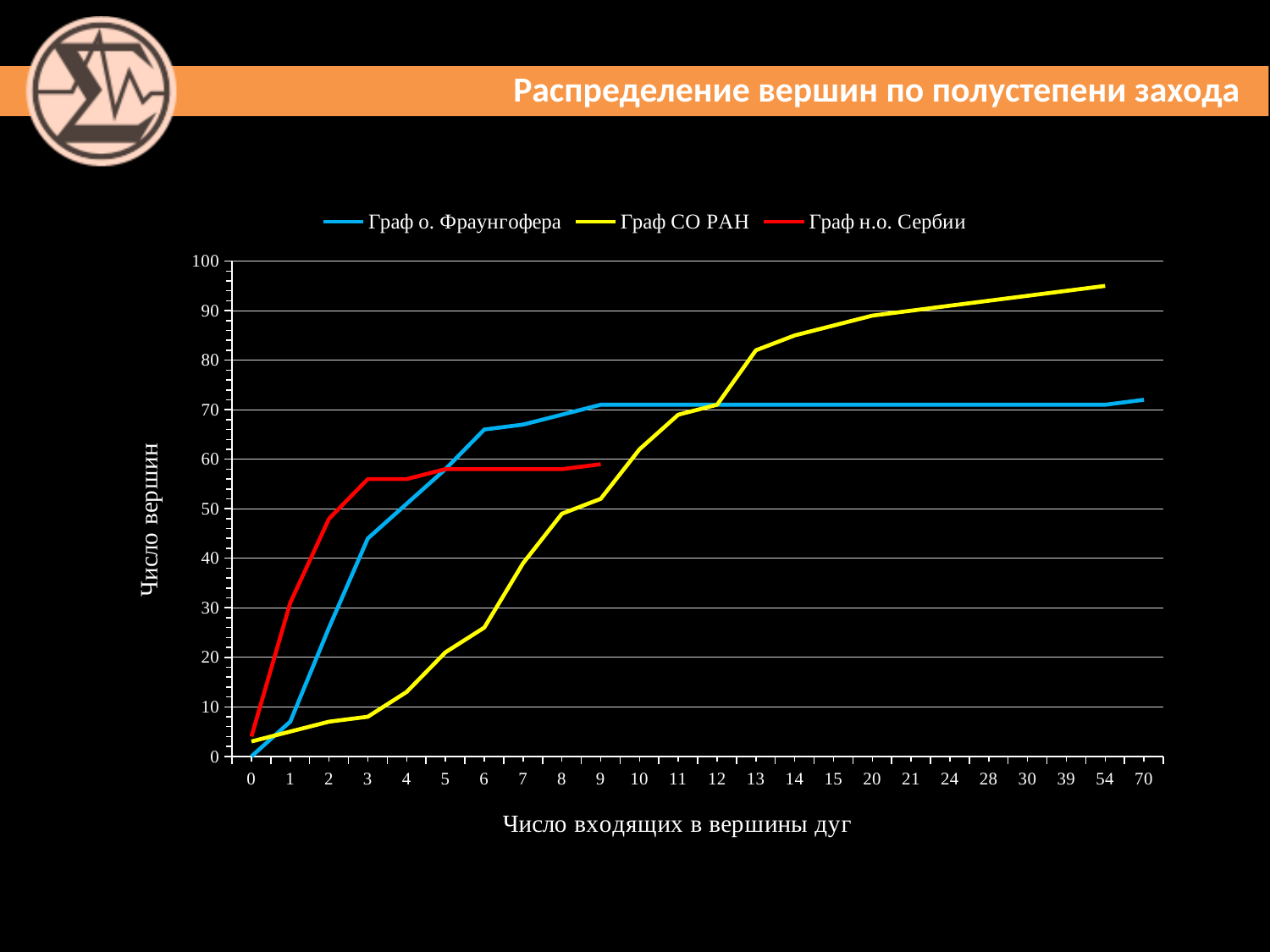
At x = 2, which series has the larger value: Граф н.о. Сербии or Граф о. Фраунгофера? Граф н.о. Сербии What kind of chart is shown on the slide? line chart How many series does the legend list? 3 Is the value for Граф о. Фраунгофера at x = 6 greater or less than 60? greater At x = 9, which series has the larger value: Граф о. Фраунгофера or Граф СО РАН? Граф о. Фраунгофера What is the label of the y axis? Число вершин Which series reaches the highest value on the chart? Граф СО РАН Do the values for Граф СО РАН rise or fall along the x axis? rise Is the value for Граф СО РАН at x = 54 greater or less than 90? greater Is the value for Граф СО РАН at x = 3 greater or less than 10? less How many categories are shown on the x axis? 24